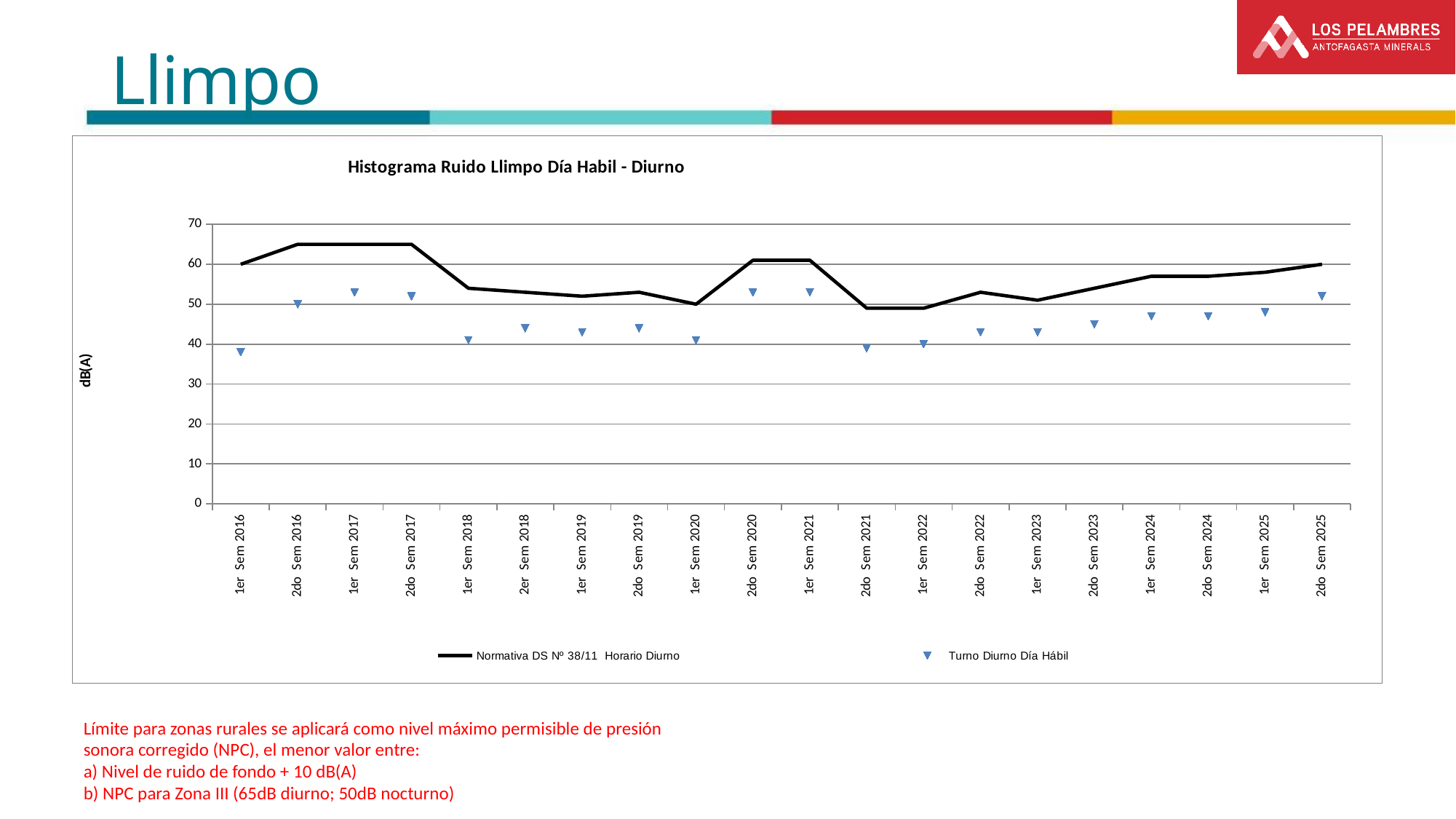
What is the title of the chart? Histograma Ruido Llimpo Día Habil - Diurno How many semester categories are shown on the x axis? 20 Is the Turno Diurno Día Hábil value for 1er Sem 2017 greater or less than 50? greater Which is larger for Turno Diurno Día Hábil: the value for 1er Sem 2017 or the value for 1er Sem 2018? 1er Sem 2017 Is the Turno Diurno Día Hábil value for 1er Sem 2016 greater or less than 40? less What is the y-axis label of the chart? dB(A) What kind of chart is shown on the slide? line chart Which is larger for Normativa DS Nº 38/11 Horario Diurno: the value for 2do Sem 2016 or the value for 1er Sem 2018? 2do Sem 2016 Is the Normativa DS Nº 38/11 Horario Diurno value for 2do Sem 2016 greater or less than 60? greater Do the Turno Diurno Día Hábil values rise or fall from 2do Sem 2022 to 1er Sem 2025? rise How many series does the legend list? 2